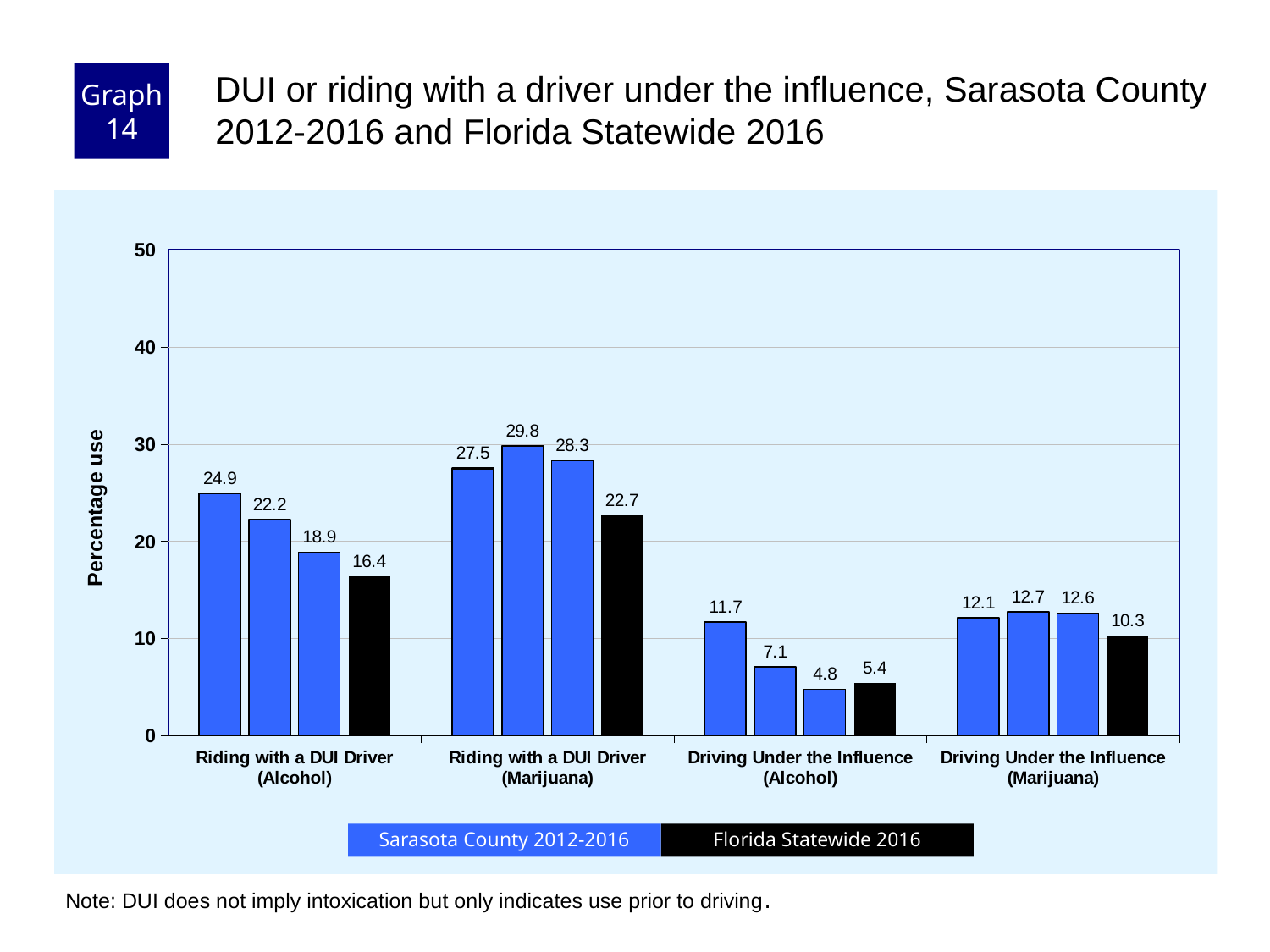
What is the Florida Statewide 2016 value for Riding with a DUI Driver (Alcohol)? 16.4 Which is larger: the Florida Statewide 2016 value for Riding with a DUI Driver (Marijuana) or for Riding with a DUI Driver (Alcohol)? Riding with a DUI Driver (Marijuana) How many series does the legend list? 2 Which category has the highest Florida Statewide 2016 value? Riding with a DUI Driver (Marijuana) What is the label of the y axis? Percentage use What is the value of the first Sarasota County bar for Riding with a DUI Driver (Marijuana)? 27.5 What is the difference between the Florida Statewide 2016 values for Riding with a DUI Driver (Alcohol) and Driving Under the Influence (Alcohol)? 11.0 What is the value of the third Sarasota County bar for Driving Under the Influence (Alcohol)? 4.8 What is the Florida Statewide 2016 value for Driving Under the Influence (Marijuana)? 10.3 How many categories are shown on the x axis? 4 Which category has the lowest Florida Statewide 2016 value? Driving Under the Influence (Alcohol) What kind of chart is shown on the slide? Bar chart